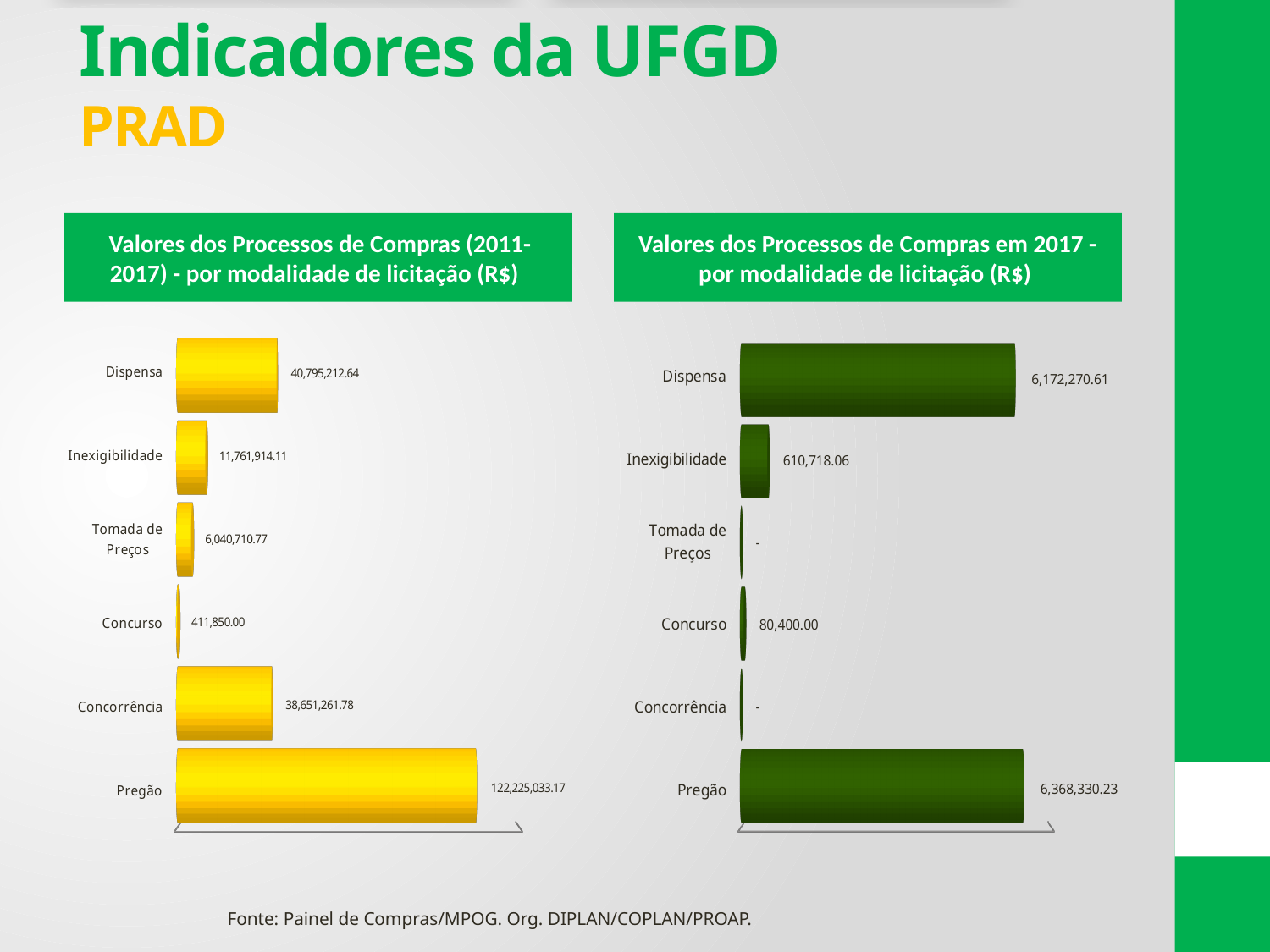
In the left chart (2011-2017), which modality has the lowest value? Concurso In the left chart (2011-2017), which modality has the highest value? Pregão How many modalities are shown in the right chart (2017)? 6 In the right chart (2017), which modality has the highest value? Pregão In the right chart (2017), what is the value for Dispensa? 6,172,270.61 In the left chart (2011-2017), what is the value for Tomada de Preços? 6,040,710.77 In the left chart (2011-2017), what is the value for Pregão? 122,225,033.17 In the right chart (2017), what is the difference between Pregão and Dispensa? 196,059.62 What type of chart is the left chart (2011-2017)? Bar chart In the left chart (2011-2017), which is larger, Dispensa or Concorrência? Dispensa In the right chart (2017), what is the value for Concurso? 80,400.00 In the left chart (2011-2017), what is the difference between Pregão and Dispensa? 81,429,820.53